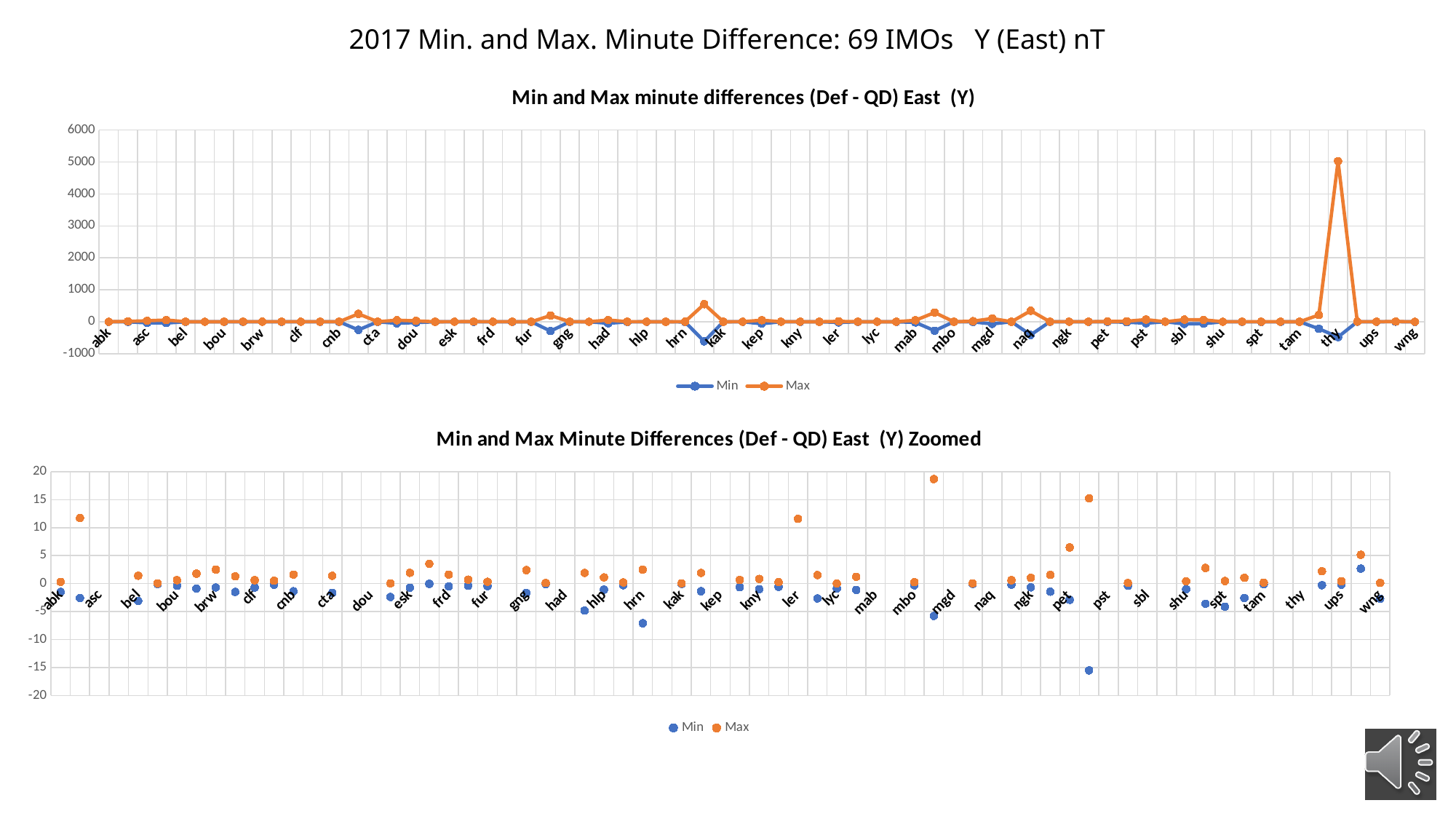
What kind of chart is the bottom chart, 'Min and Max Minute Differences (Def - QD) East (Y) Zoomed'? scatter chart What are the two series named in the legend of the bottom (Zoomed) chart? Min and Max In the top chart, which station has the highest Max value? thy In the top chart, is the Max value for thy greater or less than 4000? greater How many series does the legend of the top chart list? 2 What kind of chart is the top chart, 'Min and Max minute differences (Def - QD) East (Y)'? line chart